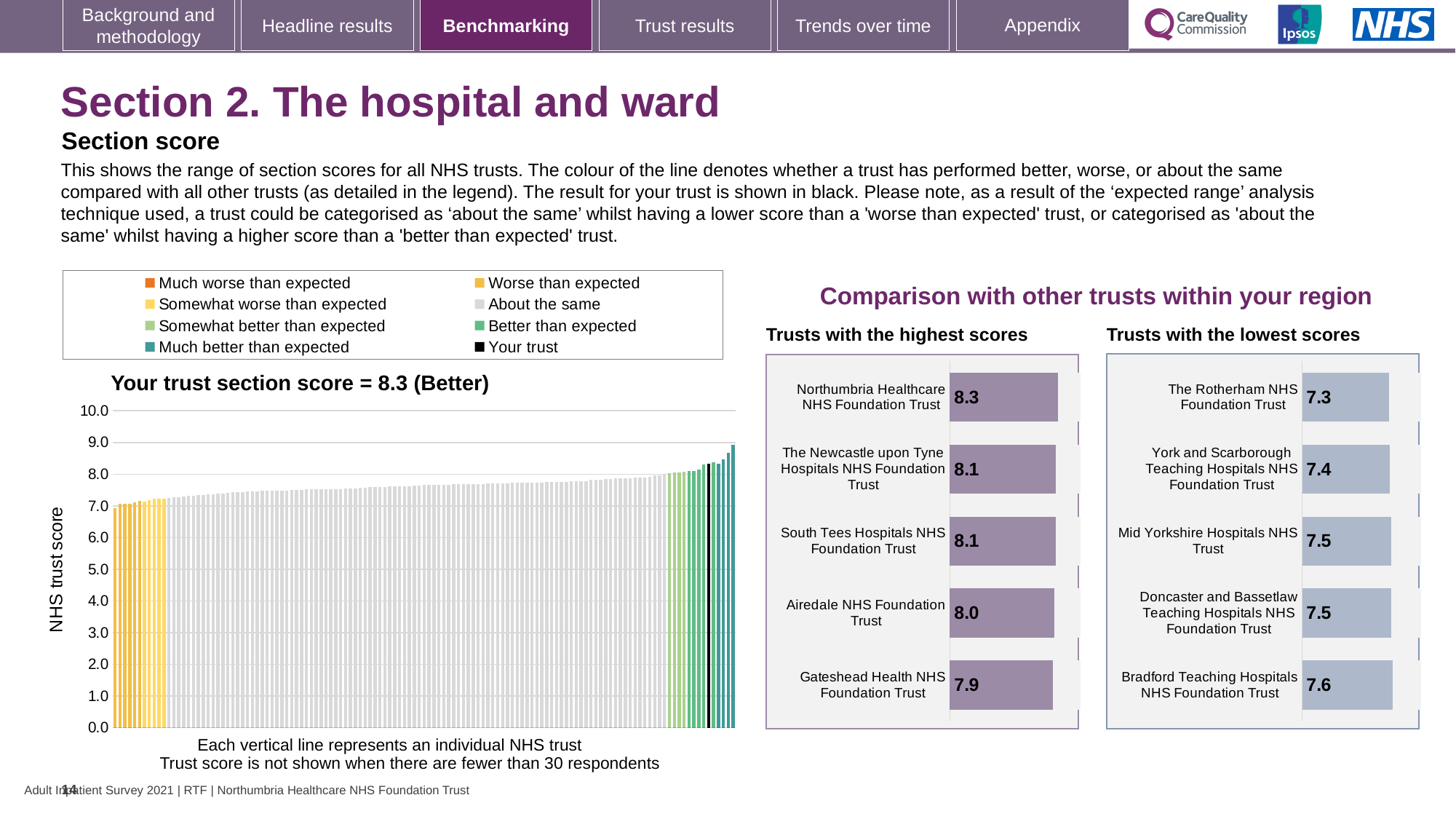
In the 'Your trust section score' chart, what is the section score for your trust? 8.3 How many entries does the legend above the 'Your trust section score' chart list? 8 In the 'Trusts with the lowest scores' chart, what is the score for Bradford Teaching Hospitals NHS Foundation Trust? 7.6 What is the y-axis label of the 'Your trust section score' chart? NHS trust score In the 'Trusts with the highest scores' chart, what is the difference between the scores of Northumbria Healthcare NHS Foundation Trust and Gateshead Health NHS Foundation Trust? 0.4 In the 'Your trust section score' chart, is the value of the tallest bar greater or less than 8.0? greater In the 'Trusts with the lowest scores' chart, which trust has the lowest score? The Rotherham NHS Foundation Trust In the 'Trusts with the highest scores' chart, what is the score for Airedale NHS Foundation Trust? 8.0 In the 'Your trust section score' chart, do the trust scores rise or fall from left to right along the x axis? rise What kind of chart is the 'Your trust section score' chart? bar chart In the 'Trusts with the highest scores' chart, which trust has the highest score? Northumbria Healthcare NHS Foundation Trust How many trusts are shown in the 'Trusts with the lowest scores' chart? 5